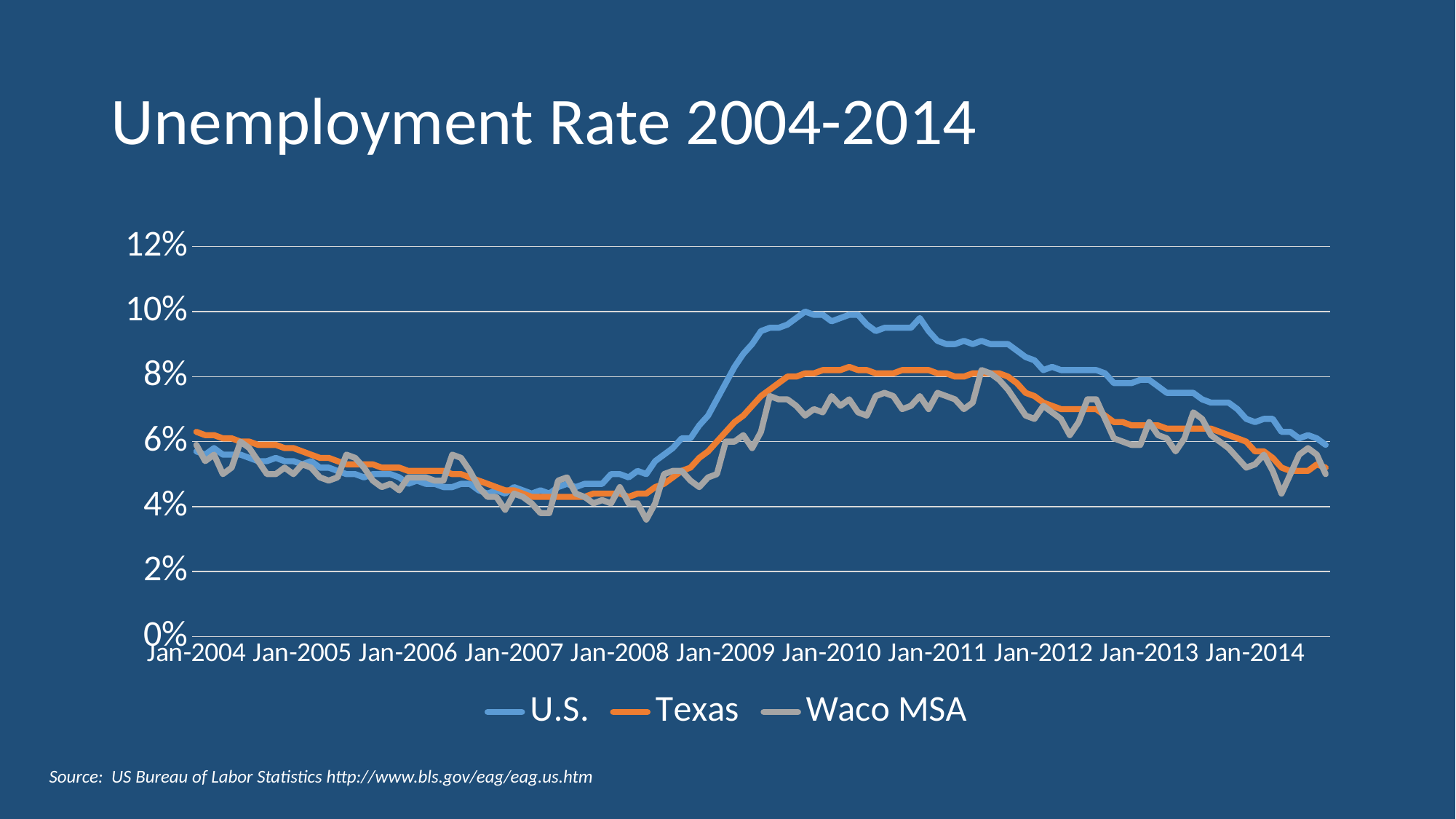
Is the Waco MSA unemployment rate at Jan-2007 greater or less than 6%? less What kind of chart is shown on the slide? line chart At Jan-2010, which series has the higher unemployment rate, U.S. or Texas? U.S. Which series reaches the highest unemployment rate at any point on the chart? U.S. How many series does the legend list? 3 Is the U.S. unemployment rate at Jan-2010 greater or less than 8%? greater What is the title of the chart? Unemployment Rate 2004-2014 Does the U.S. unemployment rate rise or fall between Jan-2008 and Jan-2010? rise Does the U.S. unemployment rate rise or fall between Jan-2010 and Jan-2014? fall Is the Texas unemployment rate at Jan-2011 greater or less than 6%? greater How many year labels are shown on the x axis? 11 Which series is drawn in orange? Texas